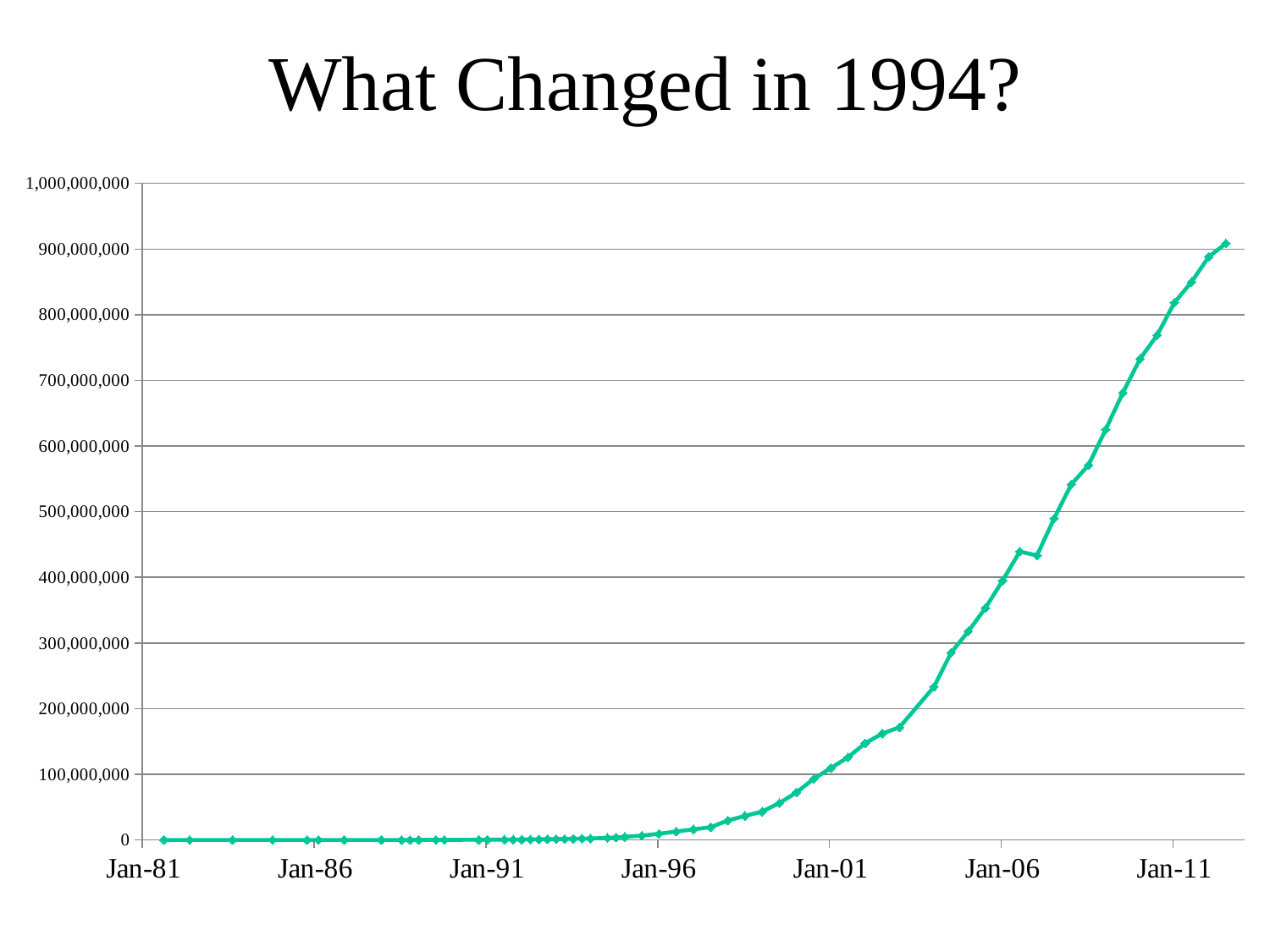
Is the value at Jan-96 greater or less than 100,000,000? less How many labelled tick marks are shown on the horizontal axis? 7 Is the value at Jan-91 greater or less than 100,000,000? less Do the plotted values generally rise or fall from Jan-81 to the end of the series? rise What is the title of the slide containing the chart? What Changed in 1994? Which is larger, the value at Jan-86 or the value at Jan-11? Jan-11 What is the maximum value shown on the vertical axis? 1,000,000,000 Is the value at Jan-11 greater or less than 700,000,000? greater Which is larger, the value at Jan-01 or the value at Jan-06? Jan-06 What kind of chart is shown on the slide? line chart